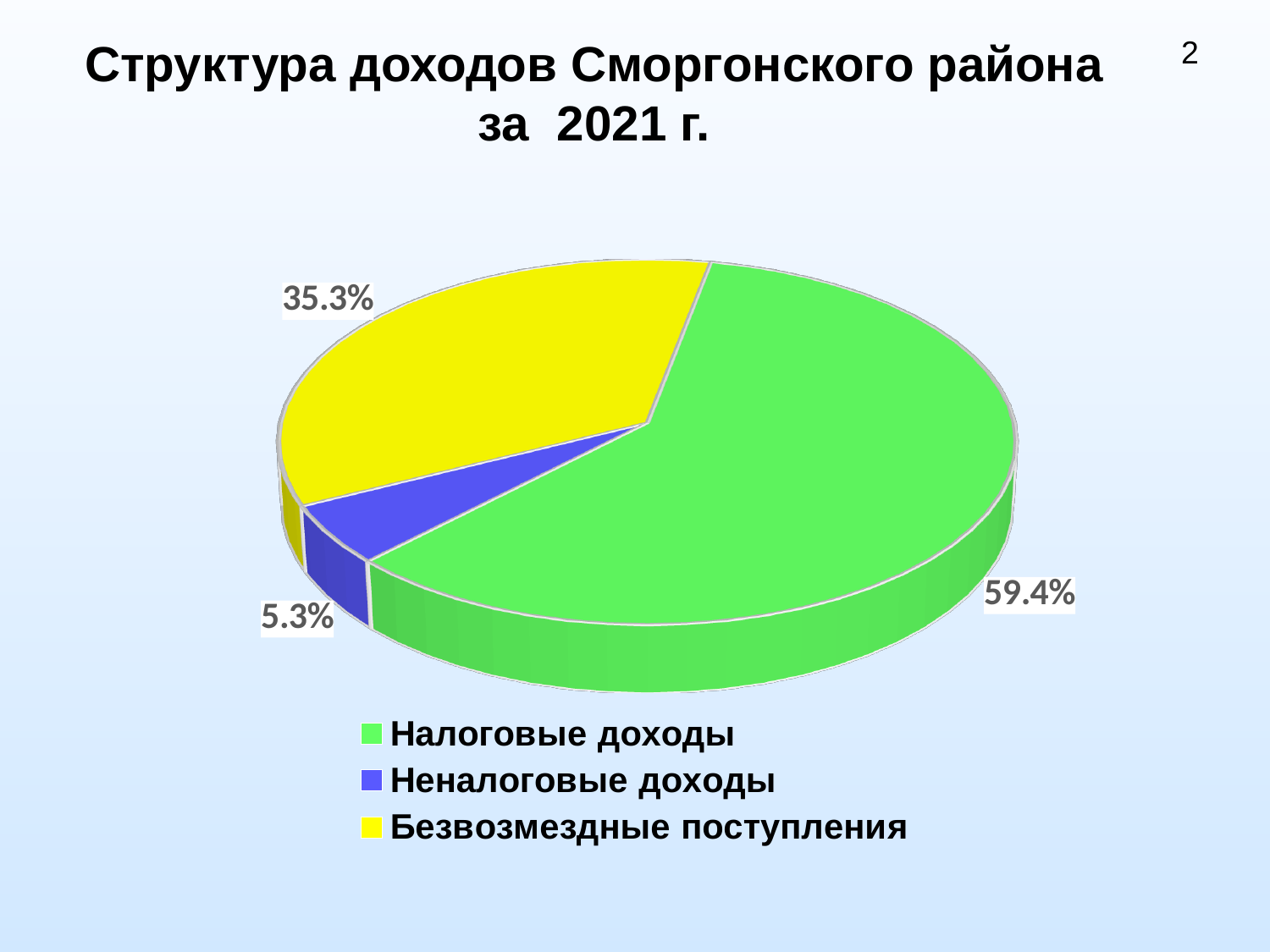
What share of the pie does Неналоговые доходы take? 5.3% What share of the pie does Налоговые доходы take? 59.4% What is the difference in percentage points between Налоговые доходы and Безвозмездные поступления? 24.1 What is the difference in percentage points between Безвозмездные поступления and Неналоговые доходы? 30 What share of the pie does Безвозмездные поступления take? 35.3% Which category has the smallest slice of the pie? Неналоговые доходы What kind of chart is shown on the slide? Pie chart What colour is the slice for Безвозмездные поступления? Yellow Which is larger, the share of Безвозмездные поступления or the share of Неналоговые доходы? Безвозмездные поступления What is the title of the chart on the slide? Структура доходов Сморгонского района за 2021 г. Which category has the largest slice of the pie? Налоговые доходы How many categories does the pie chart have? 3